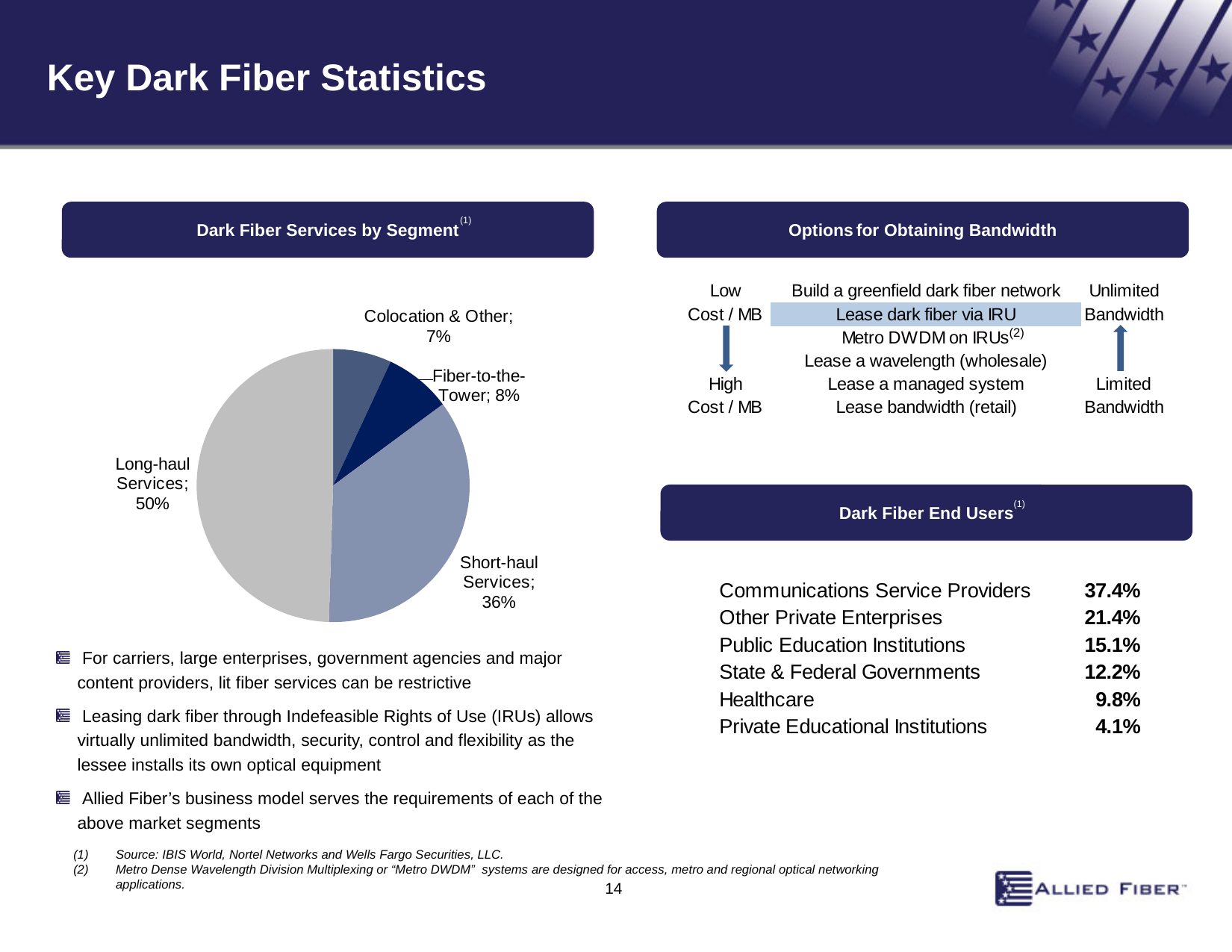
In the Dark Fiber Services by Segment pie chart, what share do Long-haul Services have? 50% In the Dark Fiber Services by Segment pie chart, what combined share do Fiber-to-the-Tower and Colocation & Other make up? 15% Which segment has the largest slice in the Dark Fiber Services by Segment pie chart? Long-haul Services In the Dark Fiber Services by Segment pie chart, what share do Short-haul Services have? 36% Which segment has the smallest slice in the Dark Fiber Services by Segment pie chart? Colocation & Other In the Dark Fiber Services by Segment pie chart, what share does Colocation & Other have? 7% What type of chart is shown under the title "Dark Fiber Services by Segment"? Pie chart What is the title of the pie chart on the left side of the slide? Dark Fiber Services by Segment In the Dark Fiber Services by Segment pie chart, which is larger: Short-haul Services or Fiber-to-the-Tower? Short-haul Services In the Dark Fiber Services by Segment pie chart, what share does Fiber-to-the-Tower have? 8% In the Dark Fiber Services by Segment pie chart, what is the difference in percentage points between Long-haul Services and Short-haul Services? 14 percentage points How many segments are shown in the Dark Fiber Services by Segment pie chart? 4